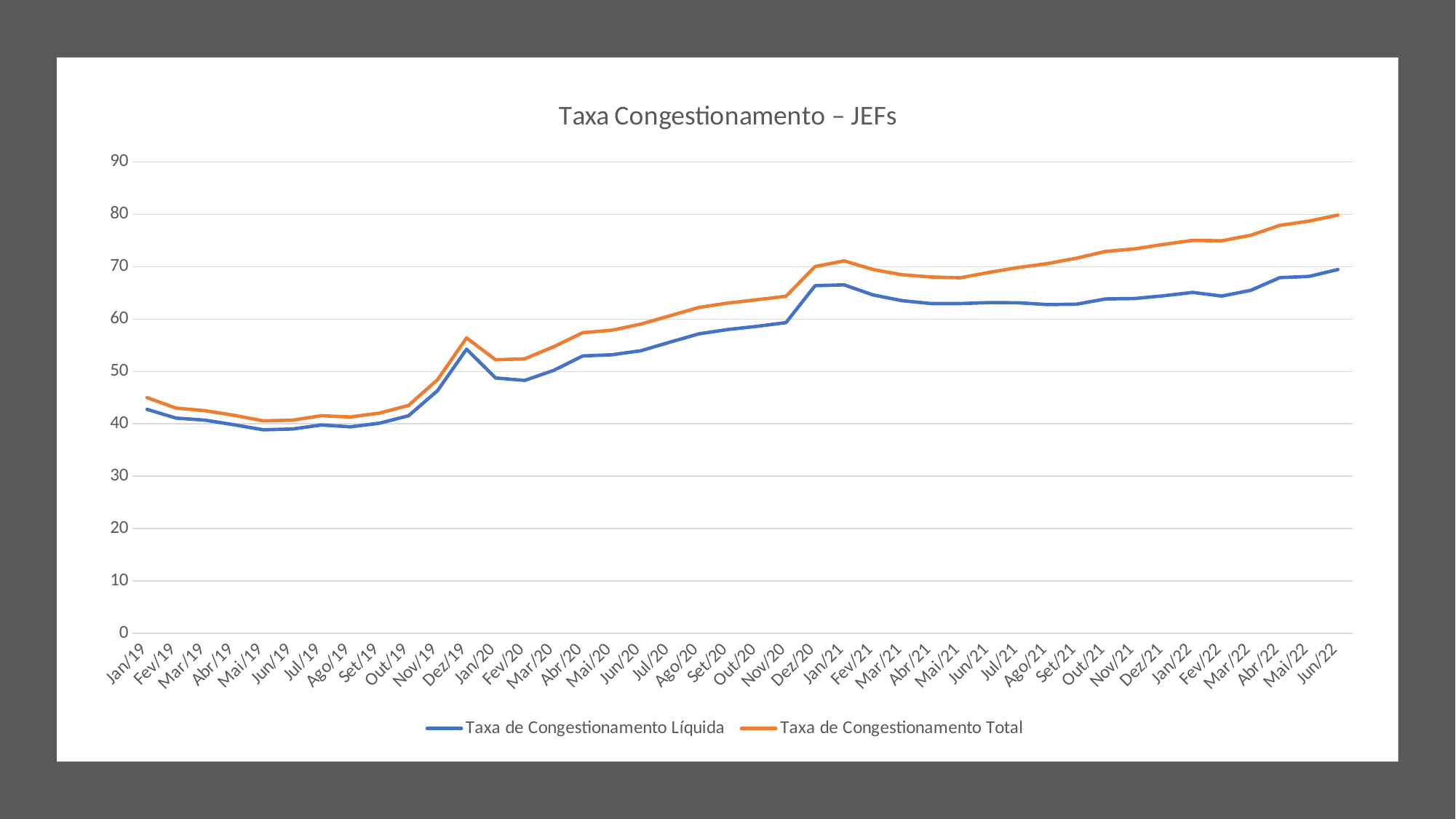
Is the value for Taxa de Congestionamento Líquida in Dez/19 greater or less than 50? greater Overall, do the values of Taxa de Congestionamento Total rise or fall from Jan/19 to Jun/22? rise What is the title of the chart? Taxa Congestionamento – JEFs Is the value for Taxa de Congestionamento Total in Abr/20 greater or less than 50? greater Which series is drawn in orange? Taxa de Congestionamento Total In which month does Taxa de Congestionamento Líquida reach its highest value? Jun/22 What kind of chart is shown on the slide? line chart How many series does the legend list? 2 How many months are plotted along the x axis? 42 Is the value for Taxa de Congestionamento Líquida in Jan/19 greater or less than 40? greater In Jan/21, which series has the higher value, Taxa de Congestionamento Líquida or Taxa de Congestionamento Total? Taxa de Congestionamento Total In which month does Taxa de Congestionamento Total reach its highest value? Jun/22